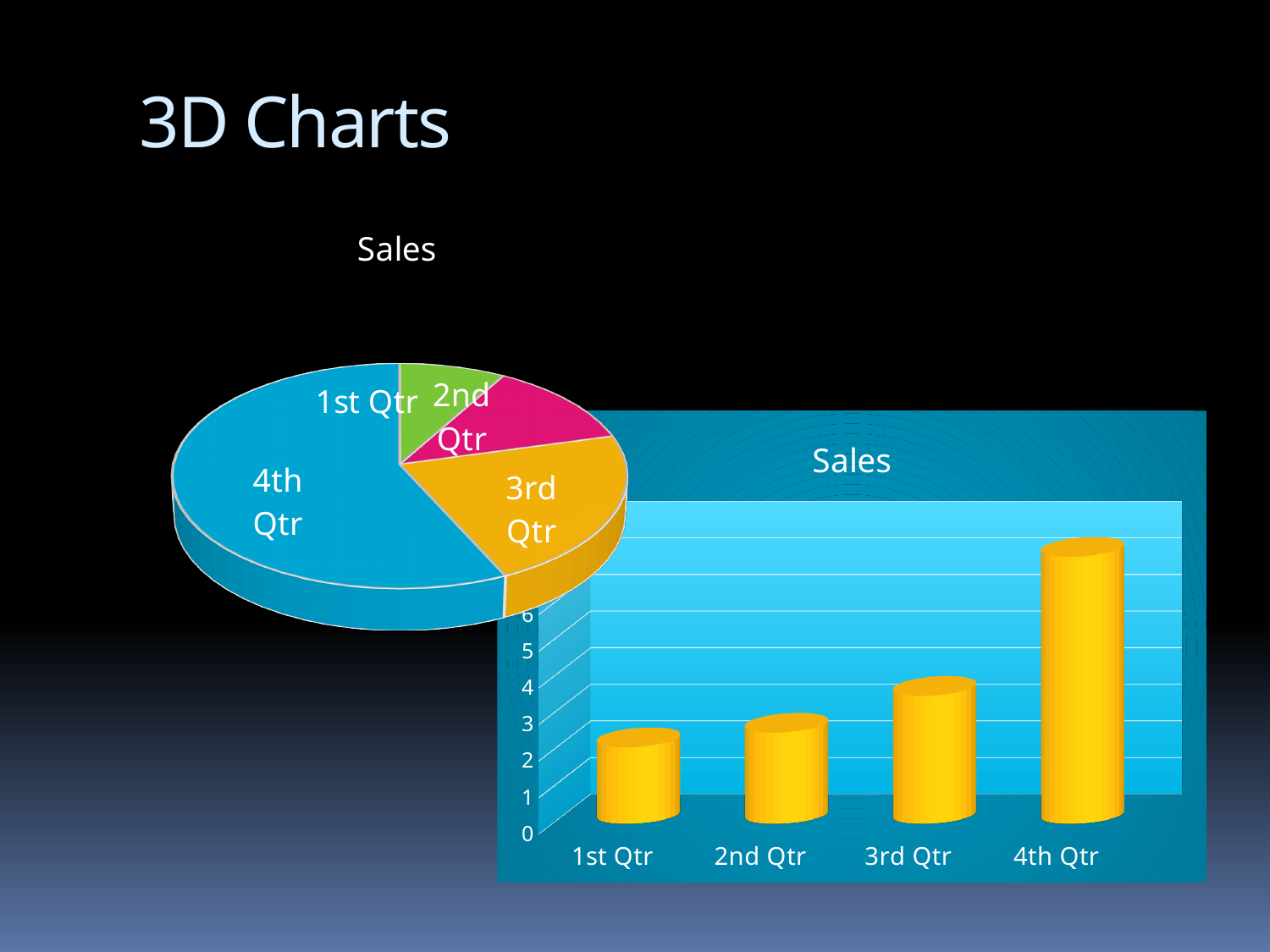
In the pie chart on the left, which quarter has the smallest slice? 1st Qtr In the bar chart on the right, is the value for 4th Qtr greater or less than 6? greater What is the title of the bar chart on the right? Sales What kind of chart is the chart on the right of the slide? bar chart What kind of chart is the chart on the left of the slide? pie chart In the bar chart on the right, which quarter has the tallest bar? 4th Qtr In the pie chart on the left, which quarter has the largest slice? 4th Qtr In the bar chart on the right, do the values rise or fall from 1st Qtr to 4th Qtr? rise In the bar chart on the right, which is larger, 3rd Qtr or 4th Qtr? 4th Qtr How many slices does the pie chart on the left have? 4 In the bar chart on the right, which quarter has the shortest bar? 1st Qtr